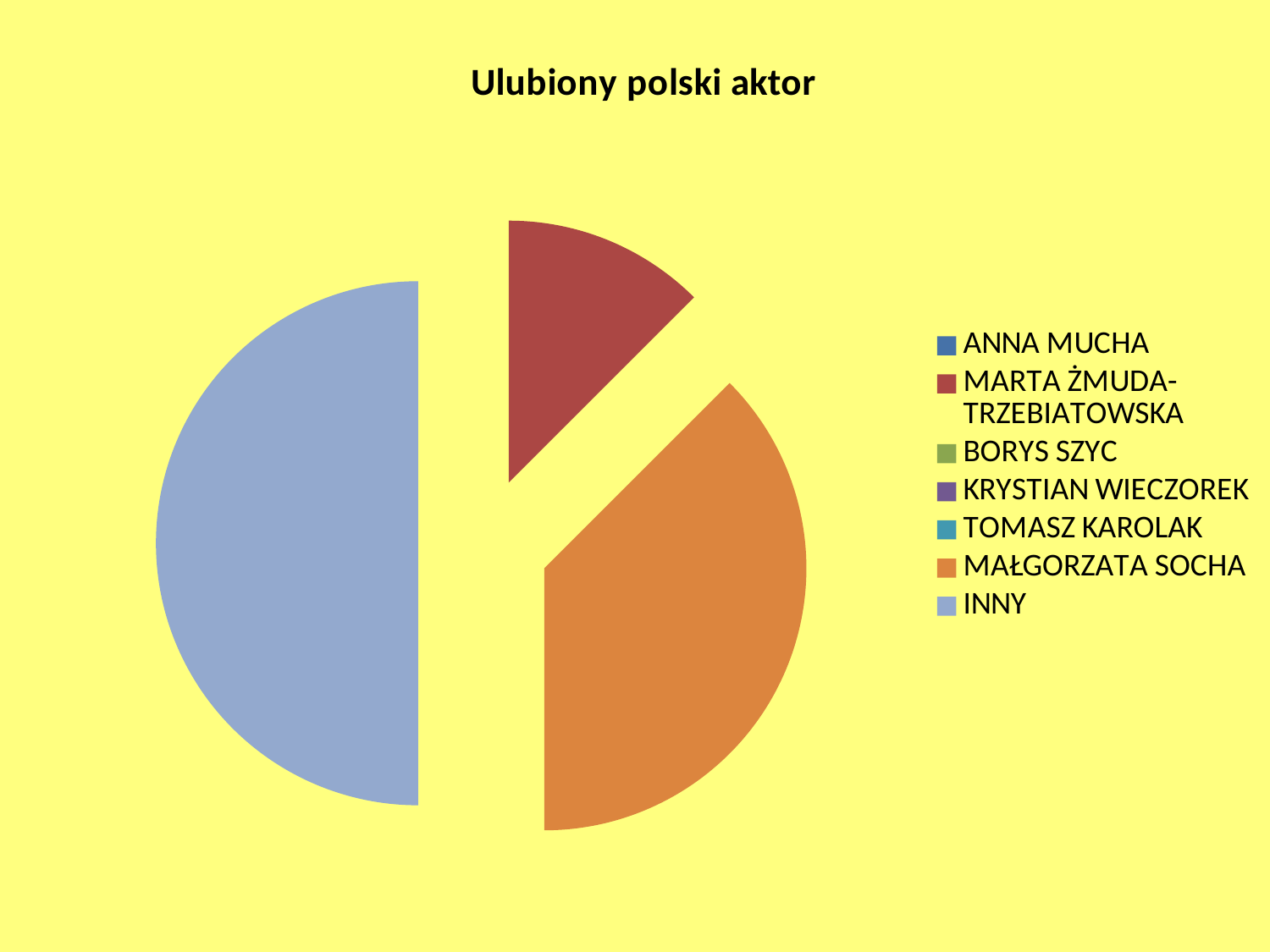
Which is larger, the slice for MAŁGORZATA SOCHA or the slice for MARTA ŻMUDA-TRZEBIATOWSKA? MAŁGORZATA SOCHA Which of the visible slices is the smallest? MARTA ŻMUDA-TRZEBIATOWSKA Which category has the largest slice of the pie? INNY What colour is the slice for MAŁGORZATA SOCHA? orange Which is larger, the slice for INNY or the slice for MARTA ŻMUDA-TRZEBIATOWSKA? INNY How many slices are visible in the pie chart? 3 Which is larger, the slice for INNY or the slice for MAŁGORZATA SOCHA? INNY What is the title of the chart? Ulubiony polski aktor What type of chart is shown on the slide? pie chart How many entries does the chart's legend list? 7